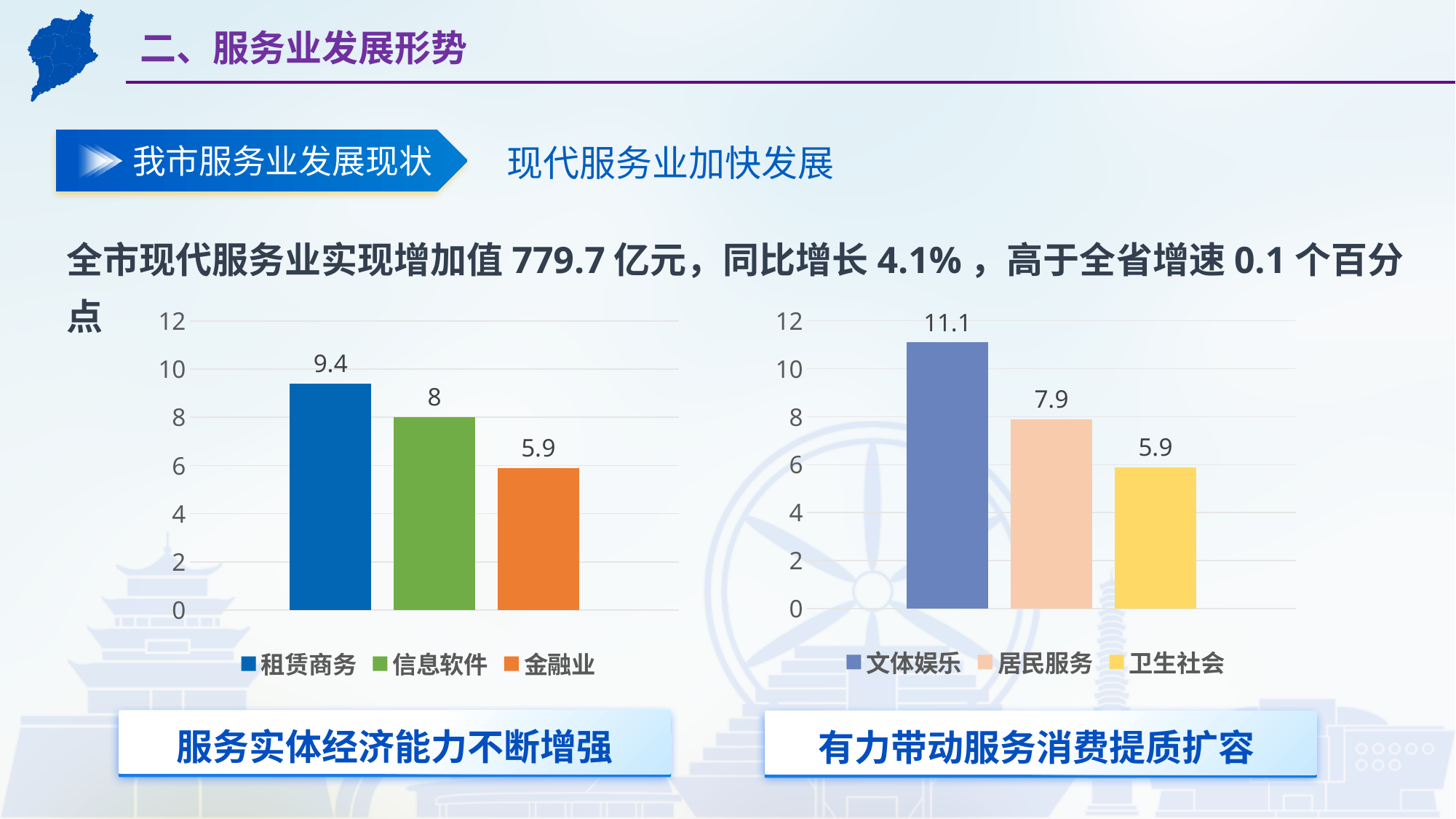
What kind of chart is the left chart? bar chart In the right chart, which is larger, the value for 居民服务 or the value for 卫生社会? 居民服务 In the left chart, what is the difference between the values for 租赁商务 and 信息软件? 1.4 In the right chart, what is the value for 居民服务? 7.9 How many bars are plotted in the left chart? 3 In the left chart, which category has the highest value? 租赁商务 In the left chart, what is the value for 租赁商务? 9.4 How many entries does the legend of the right chart list? 3 In the right chart, which category has the lowest value? 卫生社会 In the left chart, what is the value for 金融业? 5.9 In the right chart, what is the value for 文体娱乐? 11.1 In the right chart, what is the difference between the values for 文体娱乐 and 卫生社会? 5.2